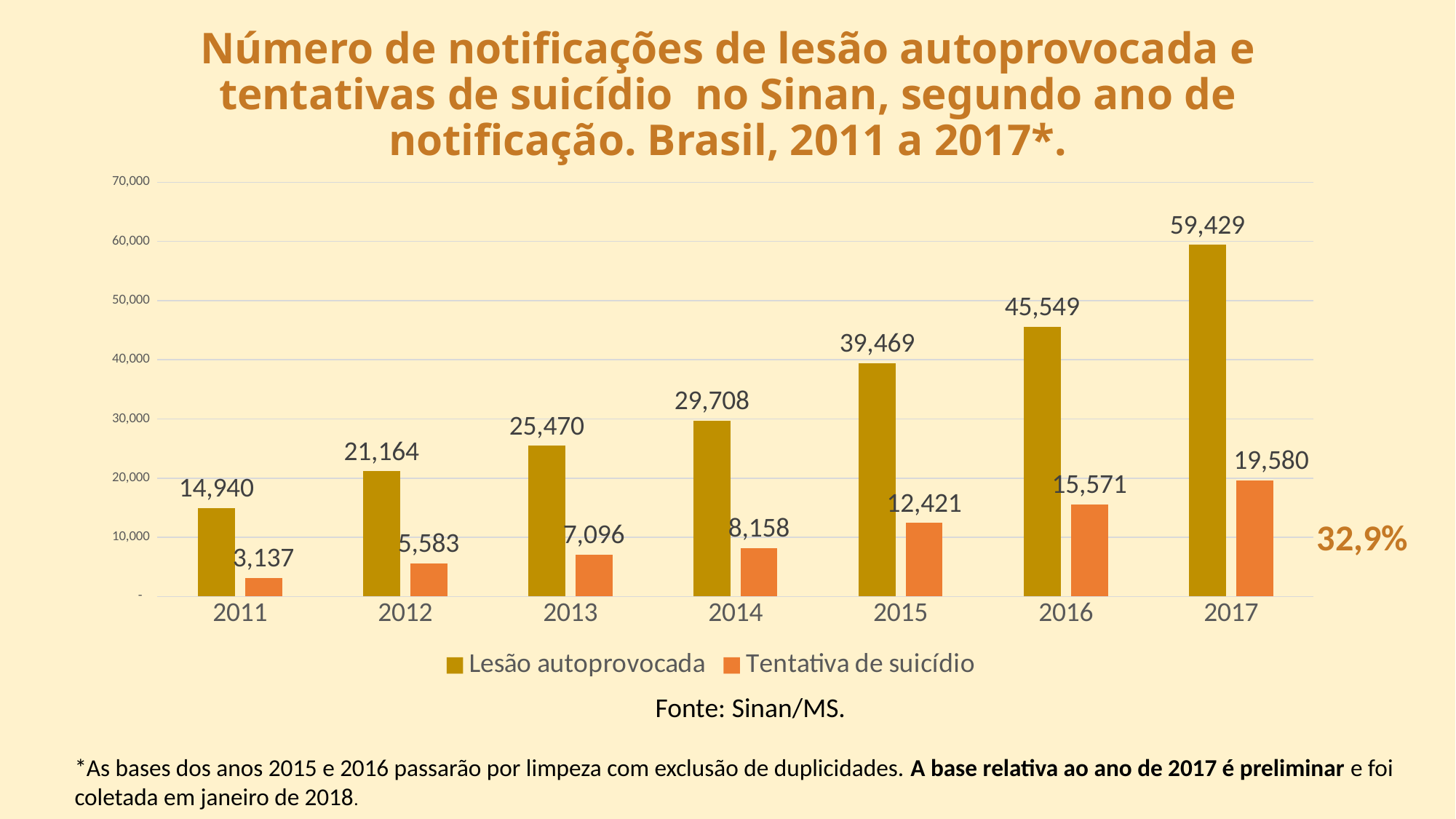
What is the value for Lesão autoprovocada in 2017? 59,429 What kind of chart is shown on the slide? Bar chart Do the values for Tentativa de suicídio rise or fall from 2011 to 2017? Rise Which year has the highest value for Tentativa de suicídio? 2017 How many years are shown on the x axis? 7 Which year has the lowest value for Lesão autoprovocada? 2011 What is the value for Tentativa de suicídio in 2013? 7,096 Which is larger: Lesão autoprovocada in 2014 or Lesão autoprovocada in 2015? Lesão autoprovocada in 2015 What is the source cited below the chart? Sinan/MS. What is the difference between Lesão autoprovocada and Tentativa de suicídio in 2016? 29,978 What is the value for Lesão autoprovocada in 2011? 14,940 How many series does the legend list? 2